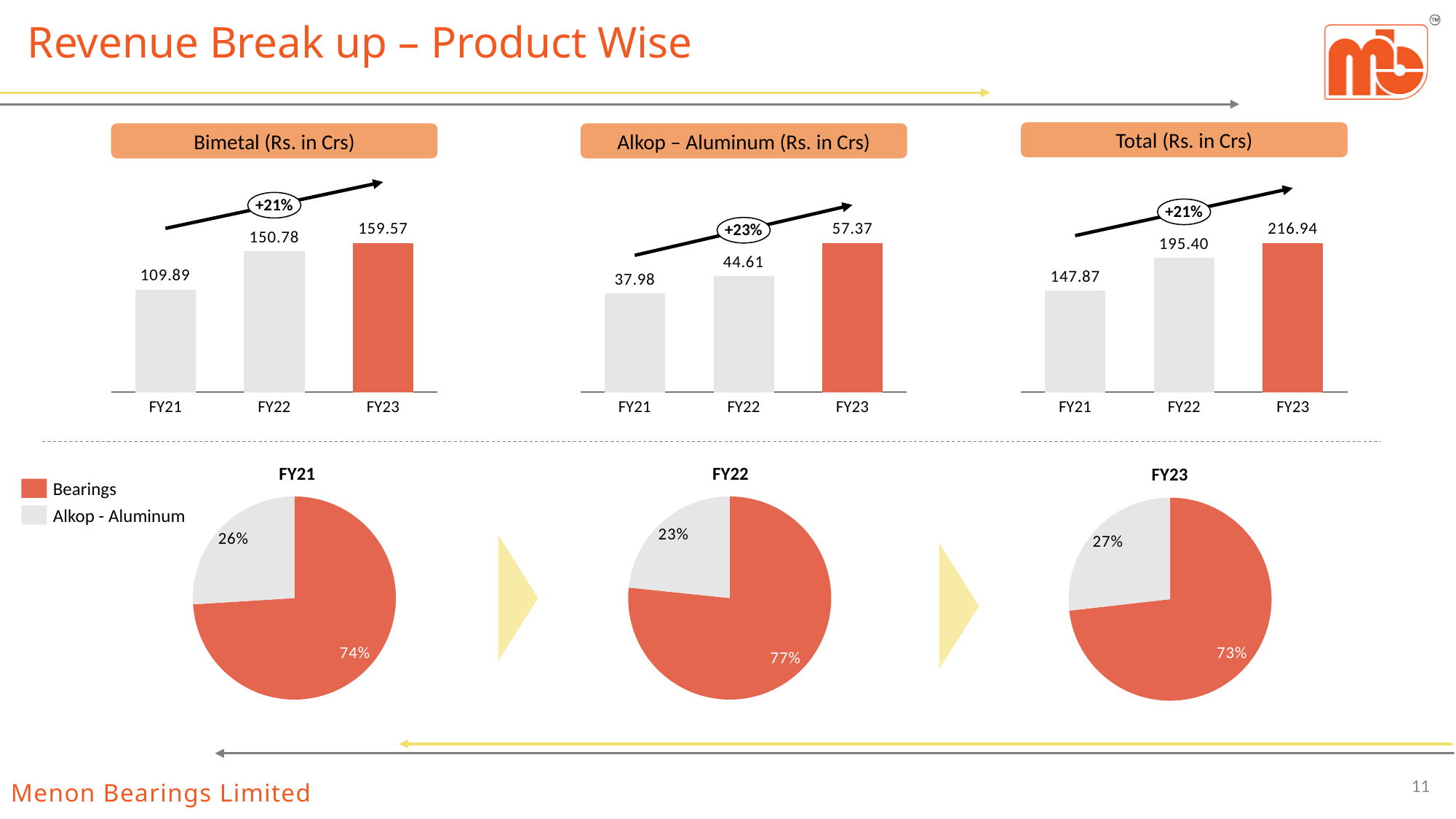
How many bars are in the Total (Rs. in Crs) chart? 3 In the Total (Rs. in Crs) chart, which year has the highest value? FY23 In the Alkop – Aluminum (Rs. in Crs) chart, what is the value for FY21? 37.98 In the Bimetal (Rs. in Crs) chart, which year has the lowest value? FY21 In the Bimetal (Rs. in Crs) chart, do the values rise or fall from FY21 to FY23? rise In the Alkop – Aluminum (Rs. in Crs) chart, what is the difference between the FY23 and FY22 values? 12.76 How many series does the legend for the pie charts list? 2 In the Total (Rs. in Crs) chart, what is the value for FY22? 195.40 In the FY22 pie chart, what share does Bearings have? 77% In the FY23 pie chart, what share does Alkop - Aluminum have? 27% What kind of chart is the Bimetal (Rs. in Crs) chart? bar chart In the Bimetal (Rs. in Crs) chart, what is the value for FY23? 159.57